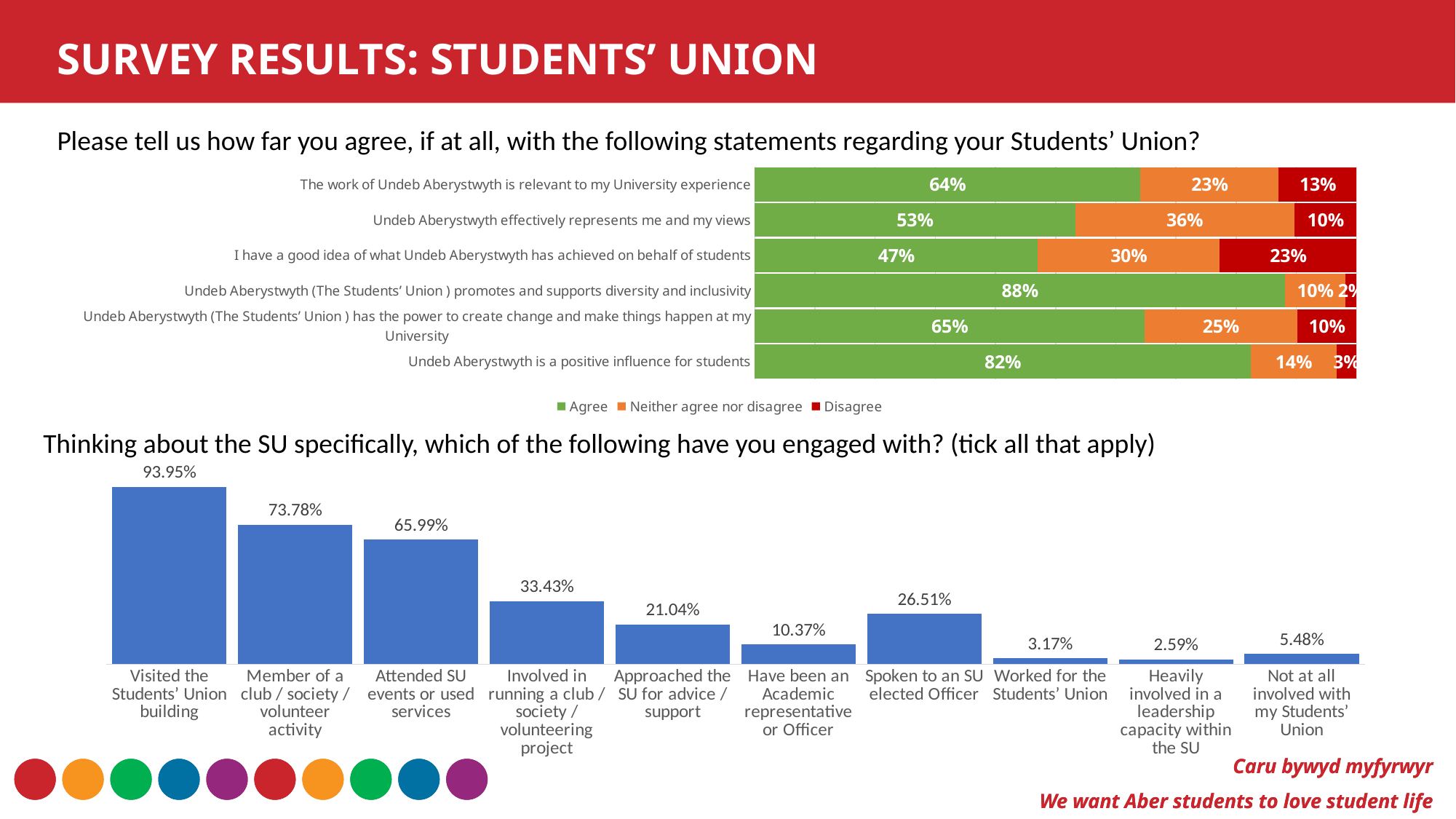
In the top chart about agreement with statements regarding the Students' Union, what is the difference between the Agree and Neither agree nor disagree percentages for 'Undeb Aberystwyth effectively represents me and my views'? 17% In the top chart about agreement with statements regarding the Students' Union, which colour represents Disagree? Red In the top chart about agreement with statements regarding the Students' Union, what percentage agree that Undeb Aberystwyth is a positive influence for students? 82% In the bottom chart about which SU activities students have engaged with, how many categories are shown? 10 What kind of chart is the bottom chart about which SU activities students have engaged with? Bar chart In the bottom chart about which SU activities students have engaged with, what percentage have visited the Students' Union building? 93.95% In the top chart about agreement with statements regarding the Students' Union, which statement has the highest Agree percentage? Undeb Aberystwyth (The Students' Union ) promotes and supports diversity and inclusivity In the top chart about agreement with statements regarding the Students' Union, which statement has the lowest Agree percentage? I have a good idea of what Undeb Aberystwyth has achieved on behalf of students In the bottom chart about which SU activities students have engaged with, which is larger: 'Spoken to an SU elected Officer' or 'Approached the SU for advice / support'? Spoken to an SU elected Officer In the top chart about agreement with statements regarding the Students' Union, what percentage disagree that they have a good idea of what Undeb Aberystwyth has achieved on behalf of students? 23% In the bottom chart about which SU activities students have engaged with, which category has the lowest value? Heavily involved in a leadership capacity within the SU In the top chart about agreement with statements regarding the Students' Union, how many series does the legend list? 3